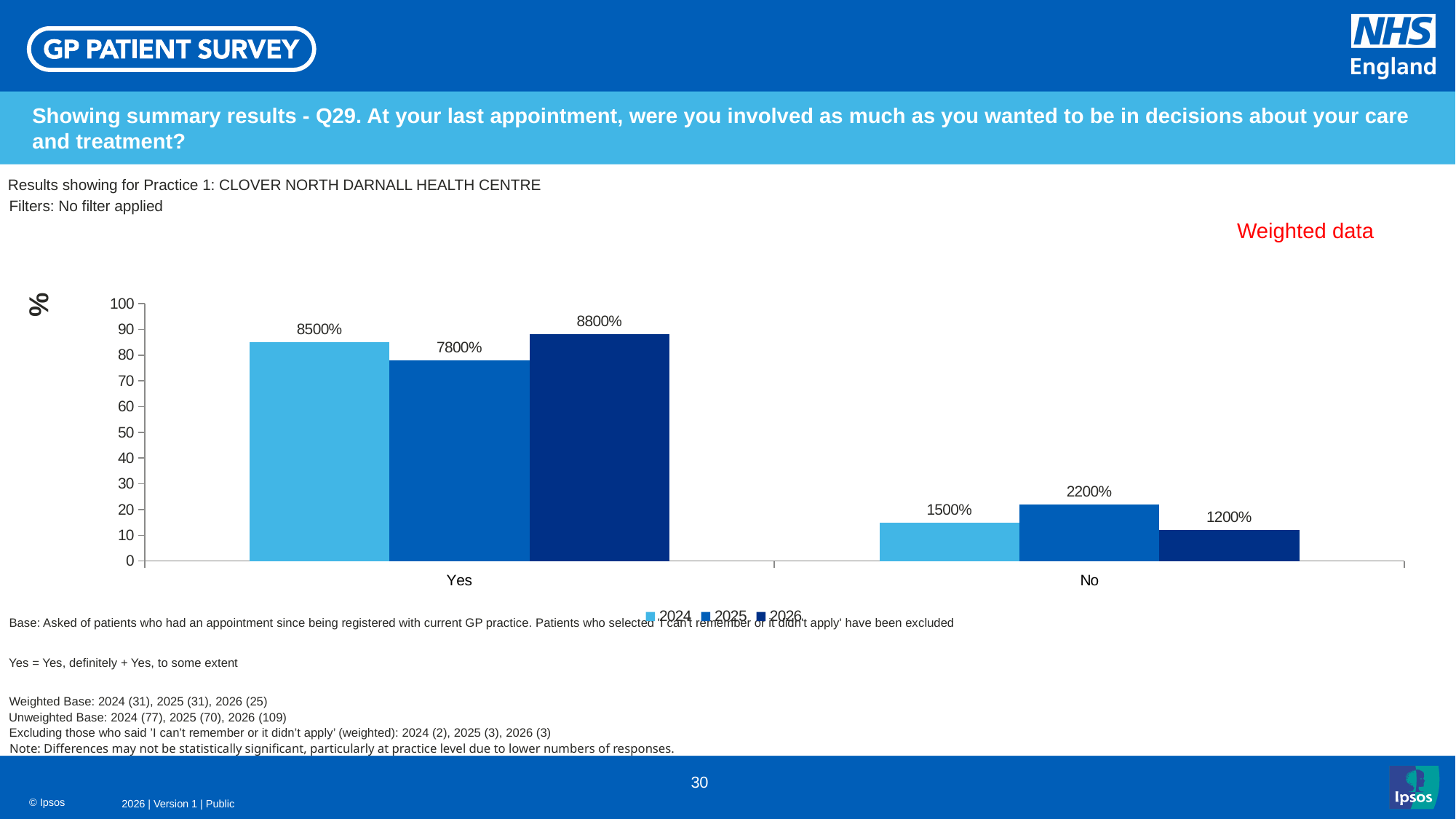
Which is larger in the Yes category: the 2024 value or the 2025 value? 2024 How many series does the legend list? 3 How many categories are shown on the x axis? 2 What kind of chart is shown on the slide? Bar chart Is the 2025 bar in the No category greater or less than 20 on the axis? greater What is the data label for the 2025 series in the No category? 2200% Which year has the highest value in the Yes category? 2026 Which year has the highest value in the No category? 2025 What is the data label for the 2024 series in the Yes category? 8500% What is the data label for the 2026 series in the Yes category? 8800% What is the data label for the 2026 series in the No category? 1200% Which year has the lowest value in the No category? 2026